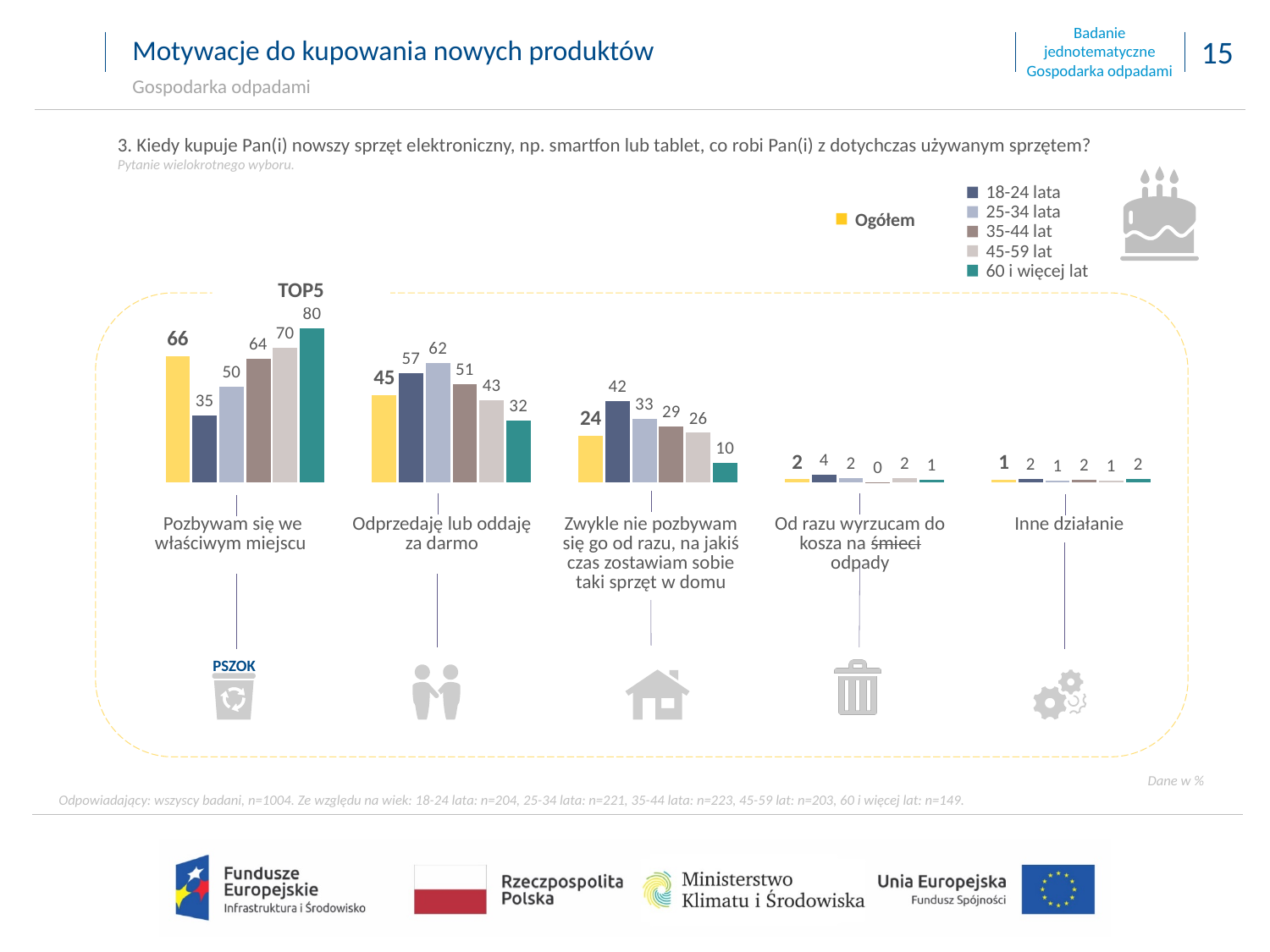
For "Odprzedaję lub oddaję za darmo", which is larger: the 25-34 lata value or the 35-44 lat value? 25-34 lata How many response categories are shown in the chart? 5 What is the Ogółem value for "Od razu wyrzucam do kosza na odpady"? 2 What kind of chart is shown on the slide? bar chart What is the value for the 60 i więcej lat group for "Odprzedaję lub oddaję za darmo"? 32 What is the difference between the 60 i więcej lat value and the 18-24 lata value for "Pozbywam się we właściwym miejscu"? 45 Which age group has the lowest value for "Odprzedaję lub oddaję za darmo"? 60 i więcej lat What is the value for the 18-24 lata group for "Zwykle nie pozbywam się go od razu, na jakiś czas zostawiam sobie taki sprzęt w domu"? 42 Which category has the highest Ogółem value? Pozbywam się we właściwym miejscu Which age group has the highest value for "Pozbywam się we właściwym miejscu"? 60 i więcej lat How many series does the legend list? 6 What is the Ogółem value for "Pozbywam się we właściwym miejscu"? 66